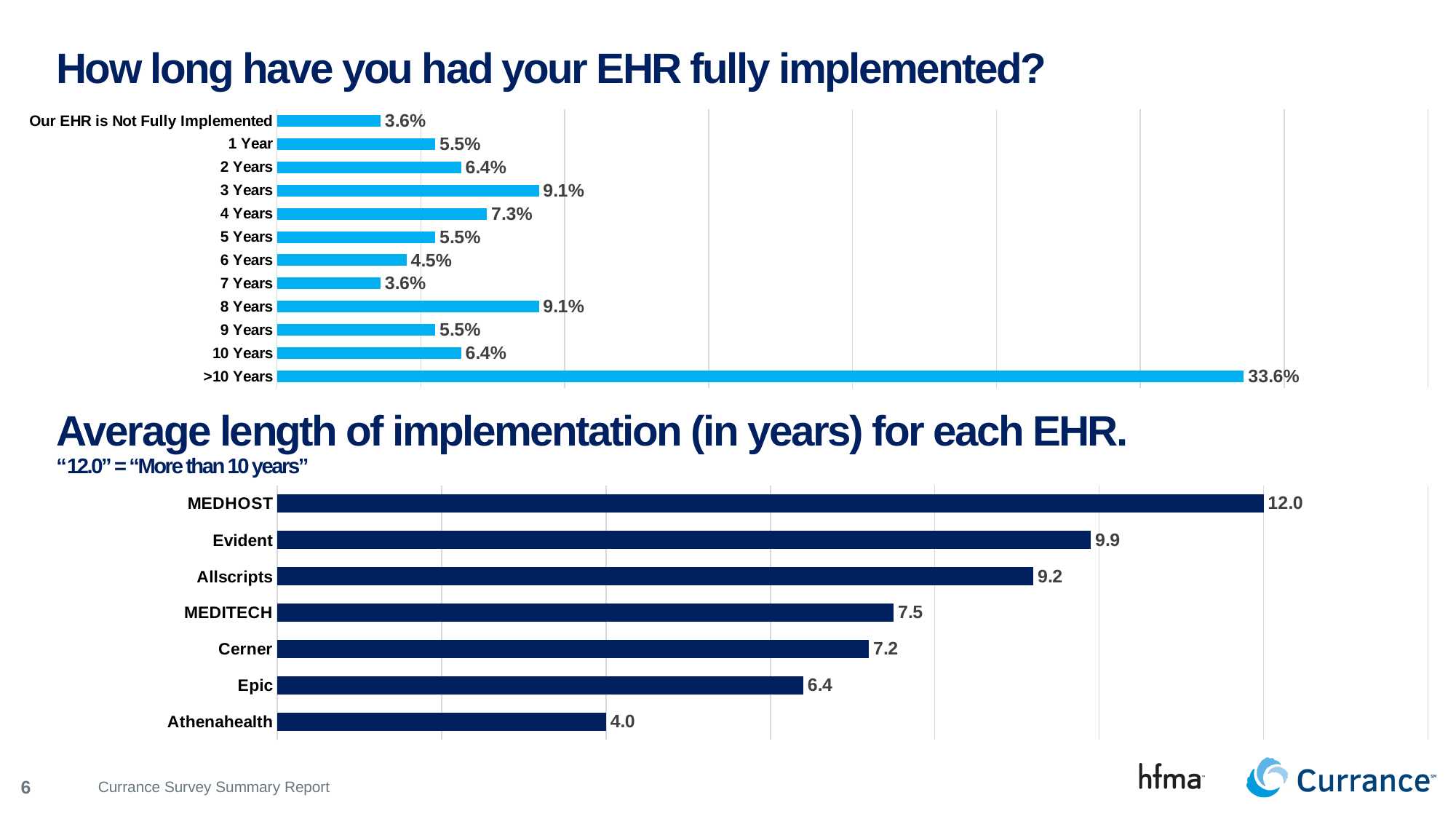
In the chart 'How long have you had your EHR fully implemented?', which category has the highest value? >10 Years In the chart 'Average length of implementation (in years) for each EHR', which EHR has the highest value? MEDHOST In the chart 'Average length of implementation (in years) for each EHR', how many EHRs are listed? 7 In the chart 'How long have you had your EHR fully implemented?', what is the difference between the values for '3 Years' and '6 Years'? 4.6% In the chart 'Average length of implementation (in years) for each EHR', what is the difference between the values for Evident and Epic? 3.5 In the chart 'How long have you had your EHR fully implemented?', what is the value for '>10 Years'? 33.6% What type of chart is the bottom chart on the slide? Bar chart In the chart 'How long have you had your EHR fully implemented?', how many categories are shown? 12 In the chart 'Average length of implementation (in years) for each EHR', which EHR has the lowest value? Athenahealth In the chart 'Average length of implementation (in years) for each EHR', what is the value for Cerner? 7.2 In the chart 'How long have you had your EHR fully implemented?', what is the value for '4 Years'? 7.3% In the chart 'How long have you had your EHR fully implemented?', which is larger, the value for '2 Years' or the value for '7 Years'? 2 Years